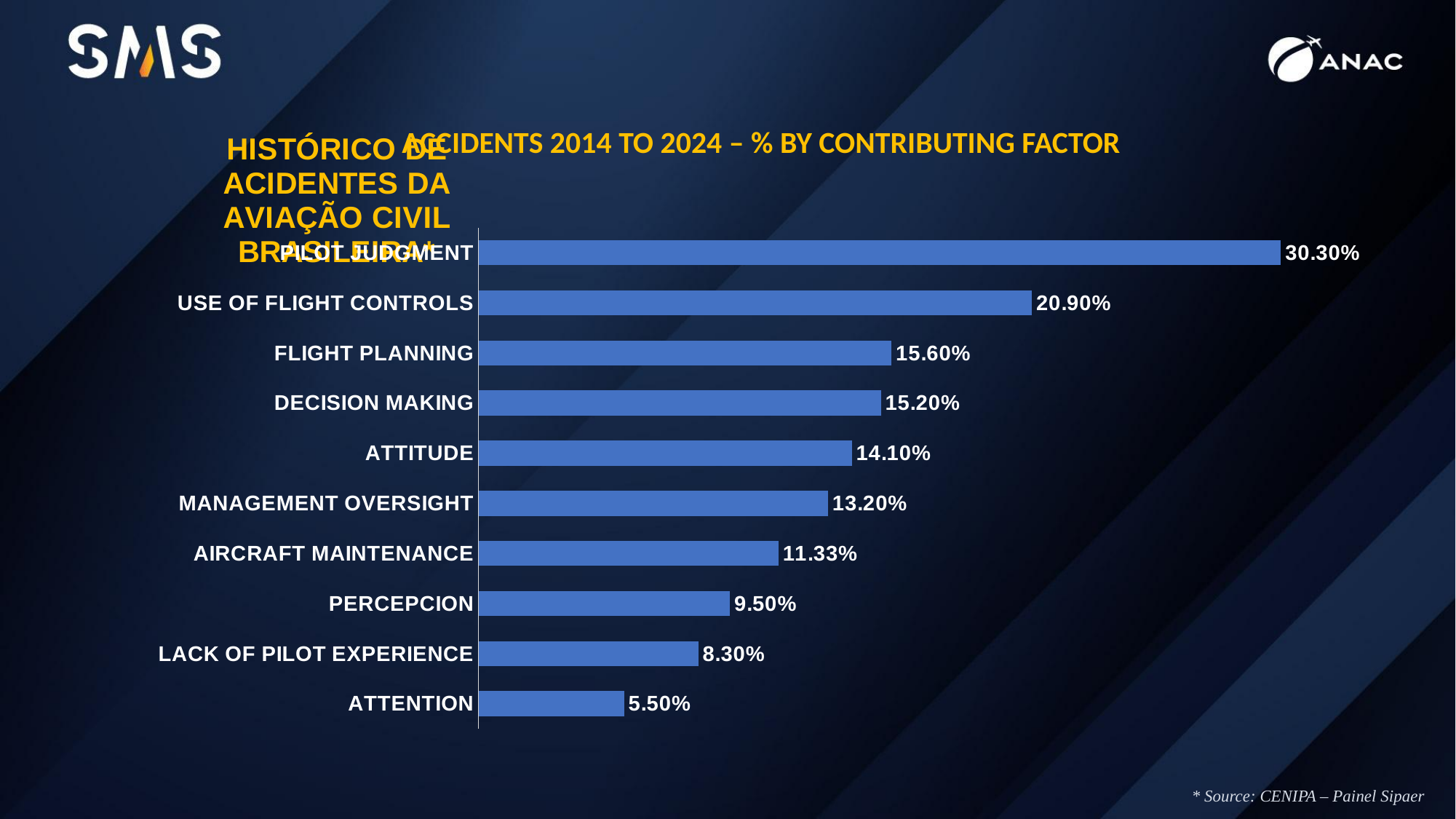
What is the value for AIRCRAFT MAINTENANCE? 11.33% Which is larger, the value for MANAGEMENT OVERSIGHT or the value for AIRCRAFT MAINTENANCE? MANAGEMENT OVERSIGHT What is the difference between the values for PILOT JUDGMENT and ATTENTION? 24.80% Which contributing factor has the highest percentage? PILOT JUDGMENT Which is larger, the value for PERCEPCION or the value for LACK OF PILOT EXPERIENCE? PERCEPCION Which contributing factor has the lowest percentage? ATTENTION What percentage is shown for ATTITUDE? 14.10% What is the title of the chart? ACCIDENTS 2014 TO 2024 – % BY CONTRIBUTING FACTOR How many contributing factors are shown in the chart? 10 What percentage is shown for USE OF FLIGHT CONTROLS? 20.90% What kind of chart is shown on the slide? Bar chart What is the difference between the values for FLIGHT PLANNING and DECISION MAKING? 0.40%